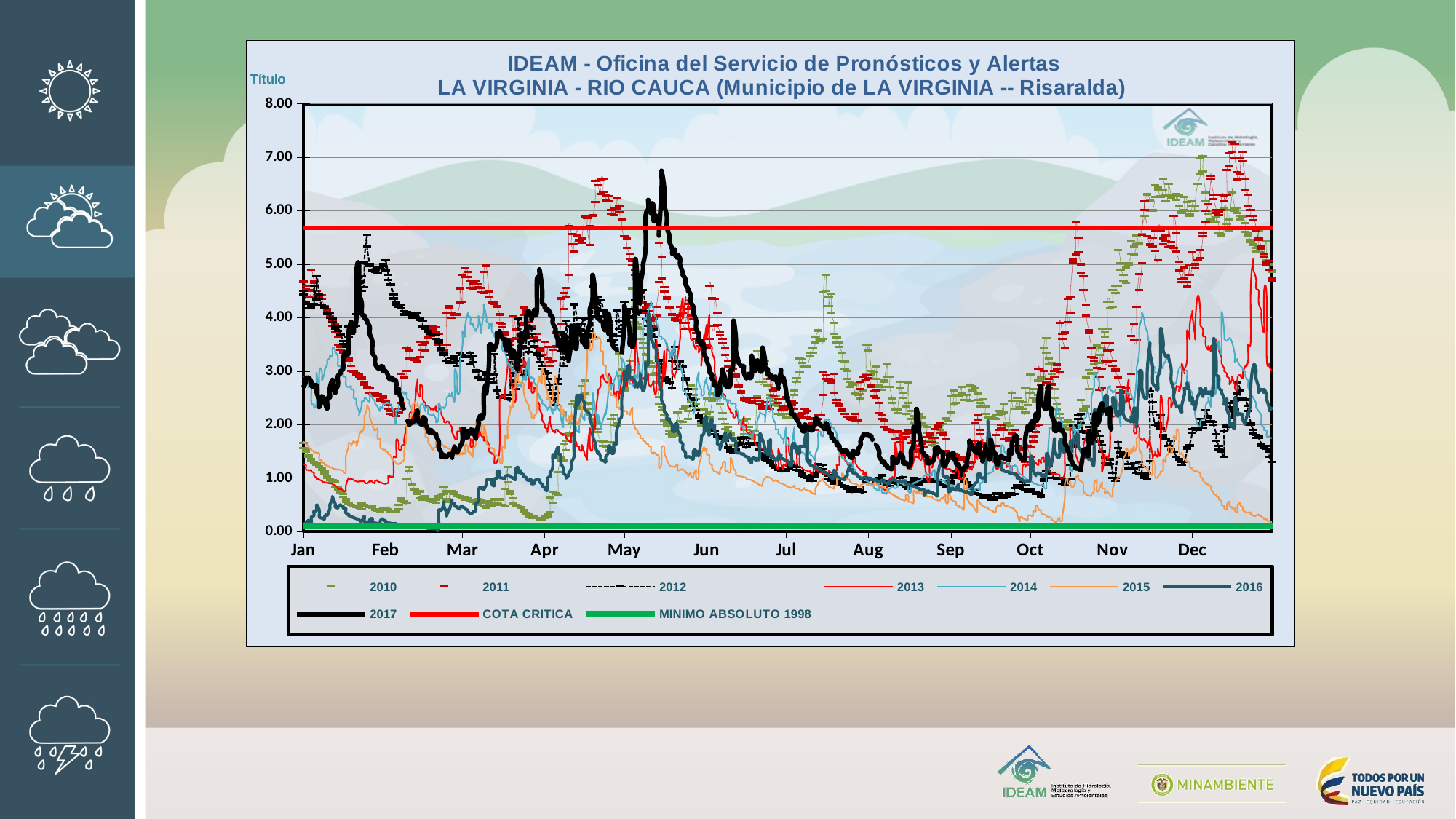
Is the peak value of the 2017 series in late May greater or less than 6.00? greater Is the COTA CRITICA line greater or less than 5.00? greater At its peak in late May, is the 2017 series above or below the COTA CRITICA line? above Does the 2017 series rise or fall from June to August? fall Is the value of the 2010 series in early February greater or less than 1.00? less How many months are labelled along the x axis? 12 How many series does the legend list? 10 What is the highest value shown on the y axis? 8.00 What colour is the COTA CRITICA line? red What kind of chart is shown on the slide? line chart